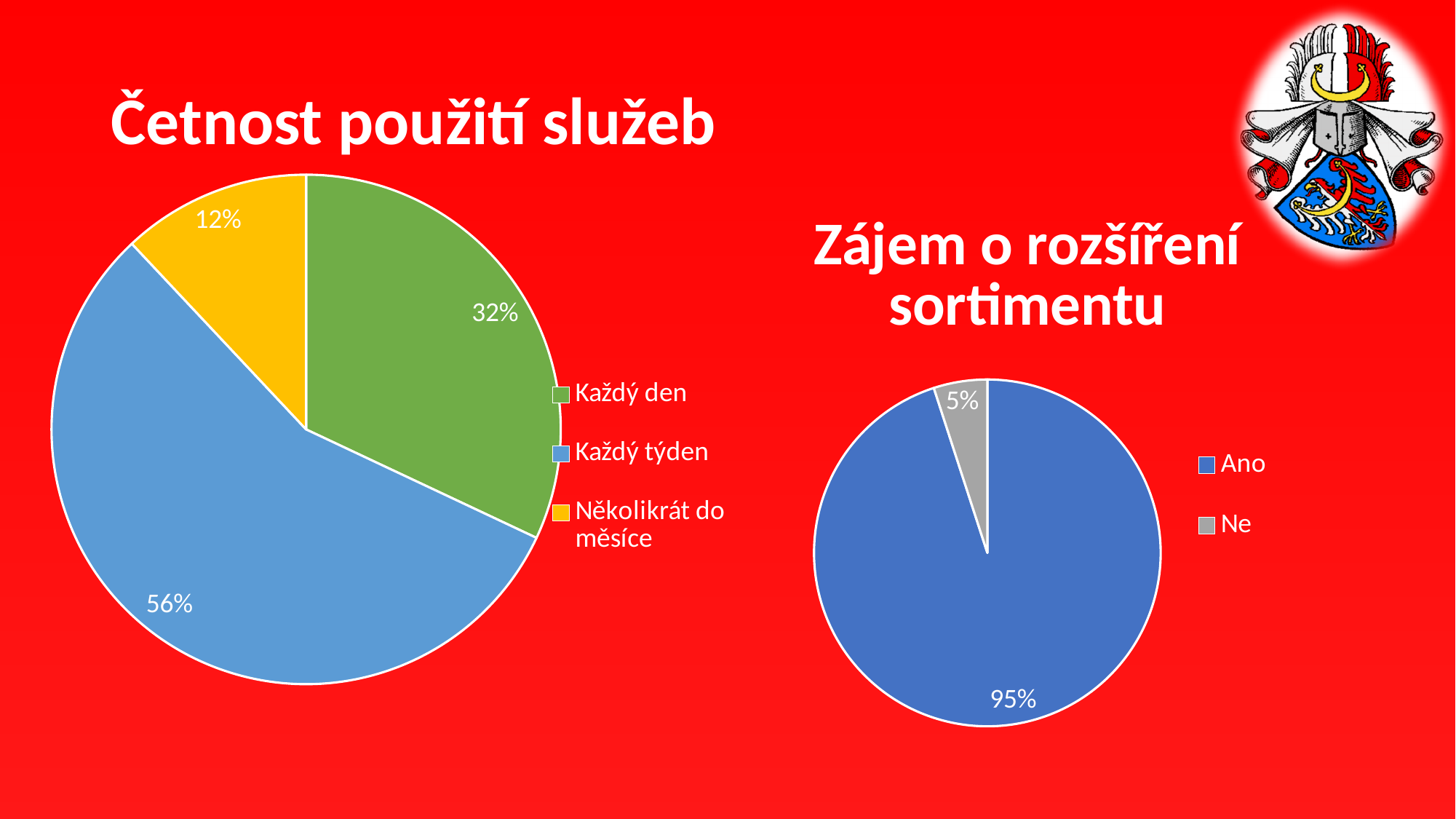
In the 'Četnost použití služeb' chart, what share is labelled for 'Každý týden'? 56% In the 'Četnost použití služeb' chart, which category has the largest slice? Každý týden In the 'Četnost použití služeb' chart, how many categories does the legend list? 3 In the 'Četnost použití služeb' chart, what share is labelled for 'Několikrát do měsíce'? 12% In the 'Zájem o rozšíření sortimentu' chart, what share is labelled for 'Ne'? 5% In the 'Zájem o rozšíření sortimentu' chart, which is larger, 'Ano' or 'Ne'? Ano In the 'Zájem o rozšíření sortimentu' chart, what share is labelled for 'Ano'? 95% In the 'Četnost použití služeb' chart, what colour is the 'Každý den' slice? Green What kind of chart is 'Zájem o rozšíření sortimentu'? Pie chart In the 'Četnost použití služeb' chart, what share is labelled for 'Každý den'? 32% In the 'Četnost použití služeb' chart, what is the difference in percentage points between 'Každý týden' and 'Každý den'? 24 In the 'Četnost použití služeb' chart, which category has the smallest slice? Několikrát do měsíce